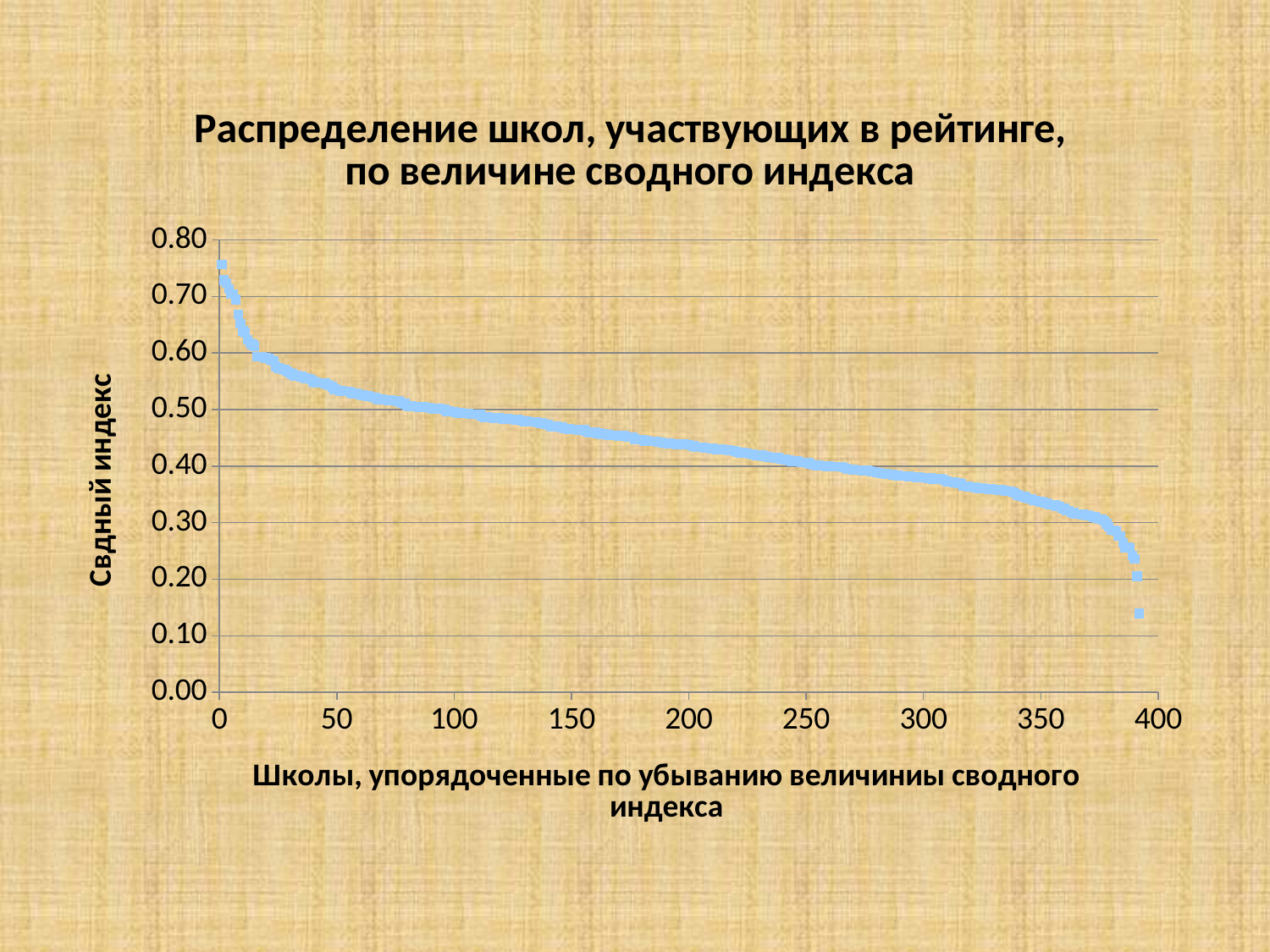
Is the value for the school at position 300 on the x axis greater or less than 0.40? less Is the value for the school at position 200 on the x axis greater or less than 0.50? less What kind of chart is shown on the slide? scatter chart Which is larger: the value at position 50 or the value at position 350 on the x axis? position 50 Is the highest plotted value greater or less than 0.70? greater What is the highest tick value shown on the y axis? 0.80 What is the label of the y axis? Свдный индекс Do the values rise or fall as you move along the x axis from left to right? fall